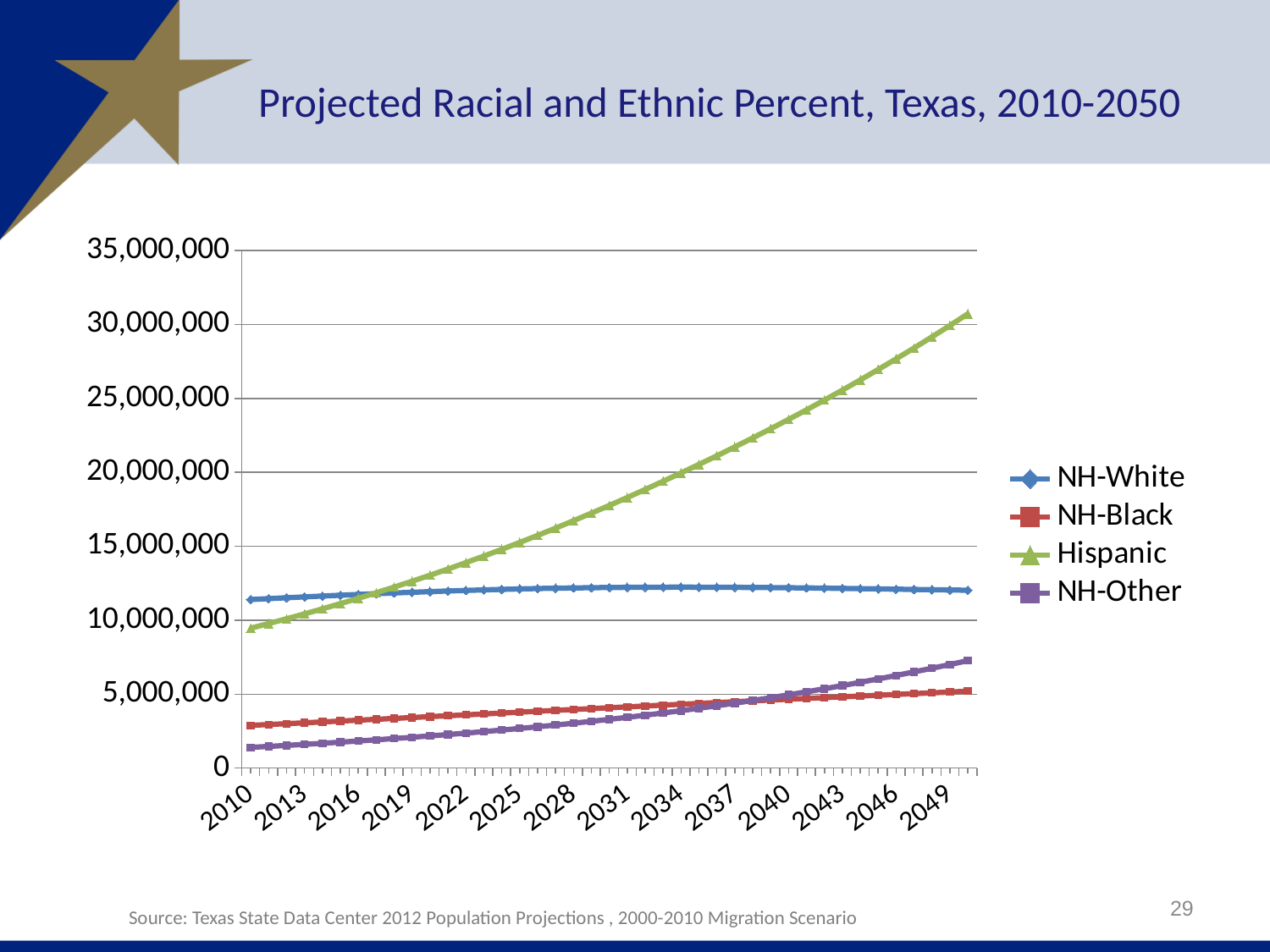
In 2010, which is larger: NH-Black or NH-Other? NH-Black Which series has the lowest value in 2010? NH-Other Is the value for Hispanic in 2010 greater or less than 10,000,000? less What is the title of the chart? Projected Racial and Ethnic Percent, Texas, 2010-2050 In 2050, which is larger: NH-Black or NH-Other? NH-Other Does the NH-Other series rise or fall from 2010 to 2050? rise Is the value for NH-White in 2010 greater or less than 10,000,000? greater Is the value for Hispanic in 2050 greater or less than 25,000,000? greater How many series does the legend list? 4 What kind of chart is shown on the slide? line chart Which series has the highest value in 2050? Hispanic Does the Hispanic series rise or fall from 2010 to 2050? rise